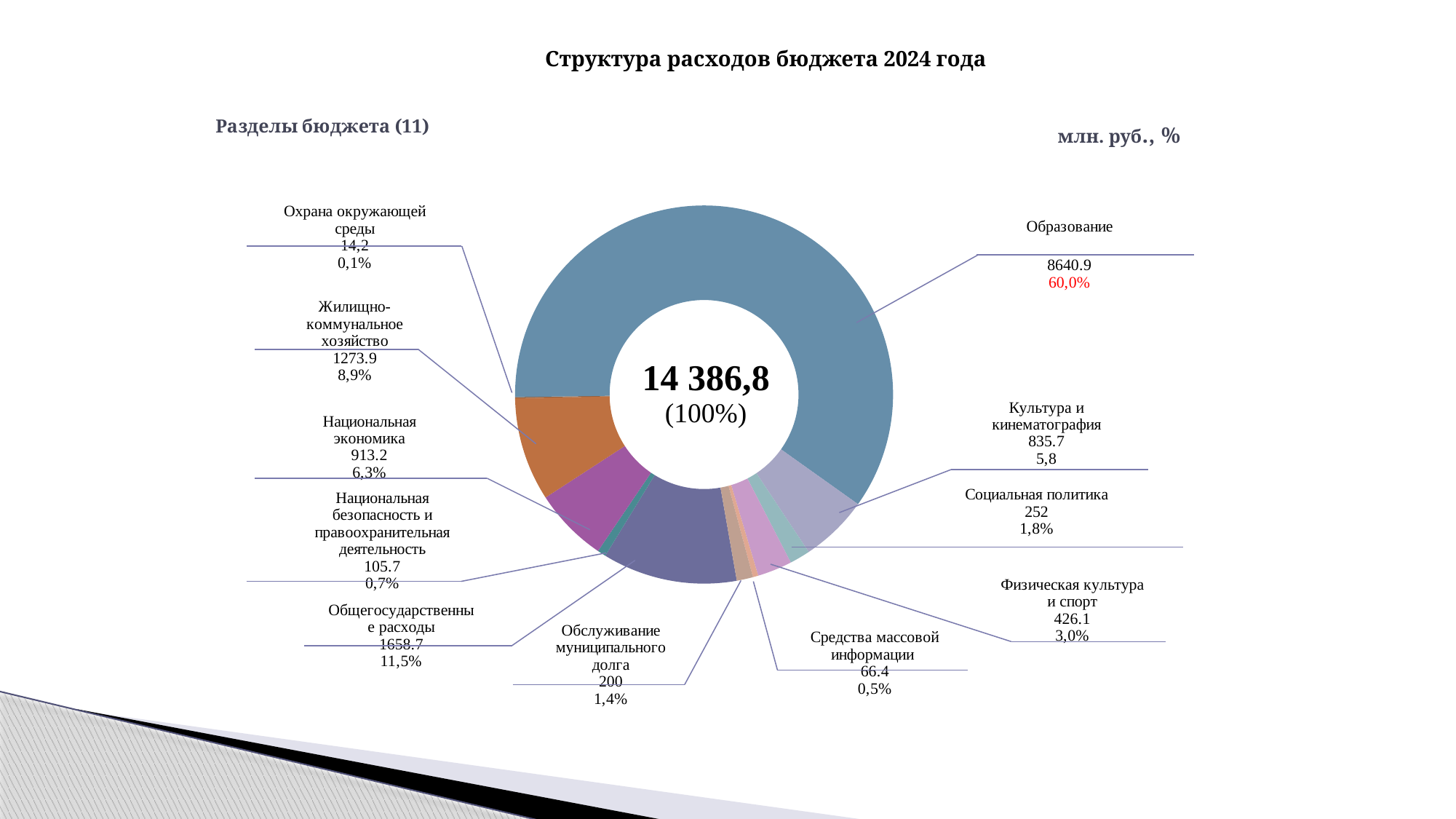
What share of the budget does Общегосударственные расходы account for? 11,5% What is the value for Образование in the chart? 8640.9 What kind of chart is shown on the slide? Doughnut (pie) chart What is the value for Жилищно-коммунальное хозяйство? 1273.9 Which budget section has the largest value? Образование Which is larger, Национальная экономика or Культура и кинематография? Национальная экономика What is the total value shown in the centre of the chart? 14 386,8 What is the value for Обслуживание муниципального долга? 200 What is the difference between the values for Общегосударственные расходы and Жилищно-коммунальное хозяйство? 384.8 How many budget sections are shown in the chart? 11 What share of the budget does Образование account for? 60,0% Which budget section has the smallest value? Охрана окружающей среды